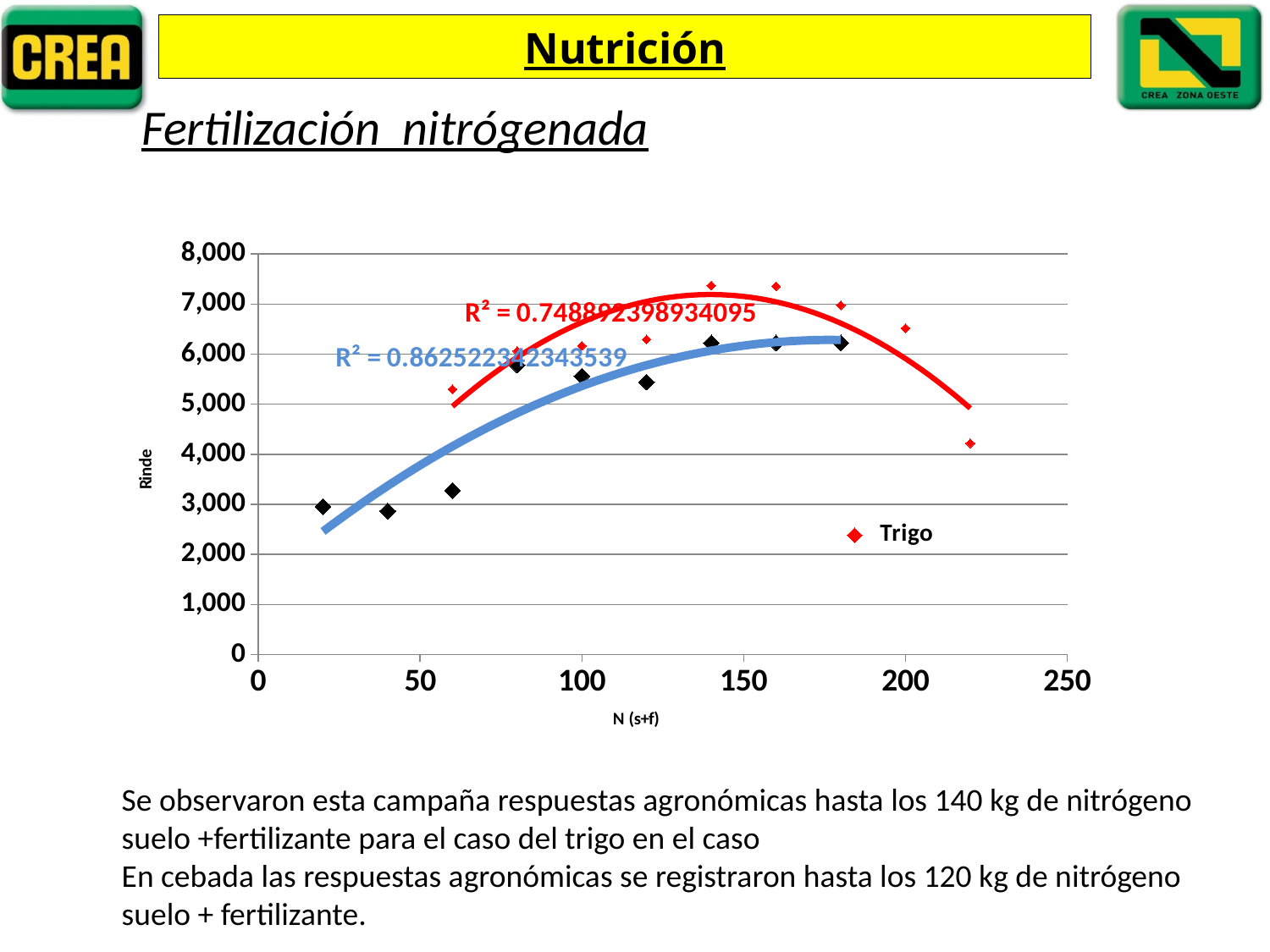
What is the title of the x axis of the chart? N (s+f) Is the Trigo value at N (s+f) = 200 greater or less than 6,000? greater Does the red Trigo trendline rise or fall between N (s+f) = 160 and N (s+f) = 220? fall What is the R² value shown in red for the Trigo trendline? 0.748892398934095 Is the Trigo value at N (s+f) = 140 greater or less than 7,000? greater Is the black-diamond value at N (s+f) = 60 greater or less than 4,000? less How many Trigo (red diamond) data points are plotted? 9 Which trendline has the higher R² value, the red one or the blue one? the blue one What kind of chart is shown on the slide? scatter chart What is the highest value shown on the y axis? 8,000 What is the title of the y axis of the chart? Rinde